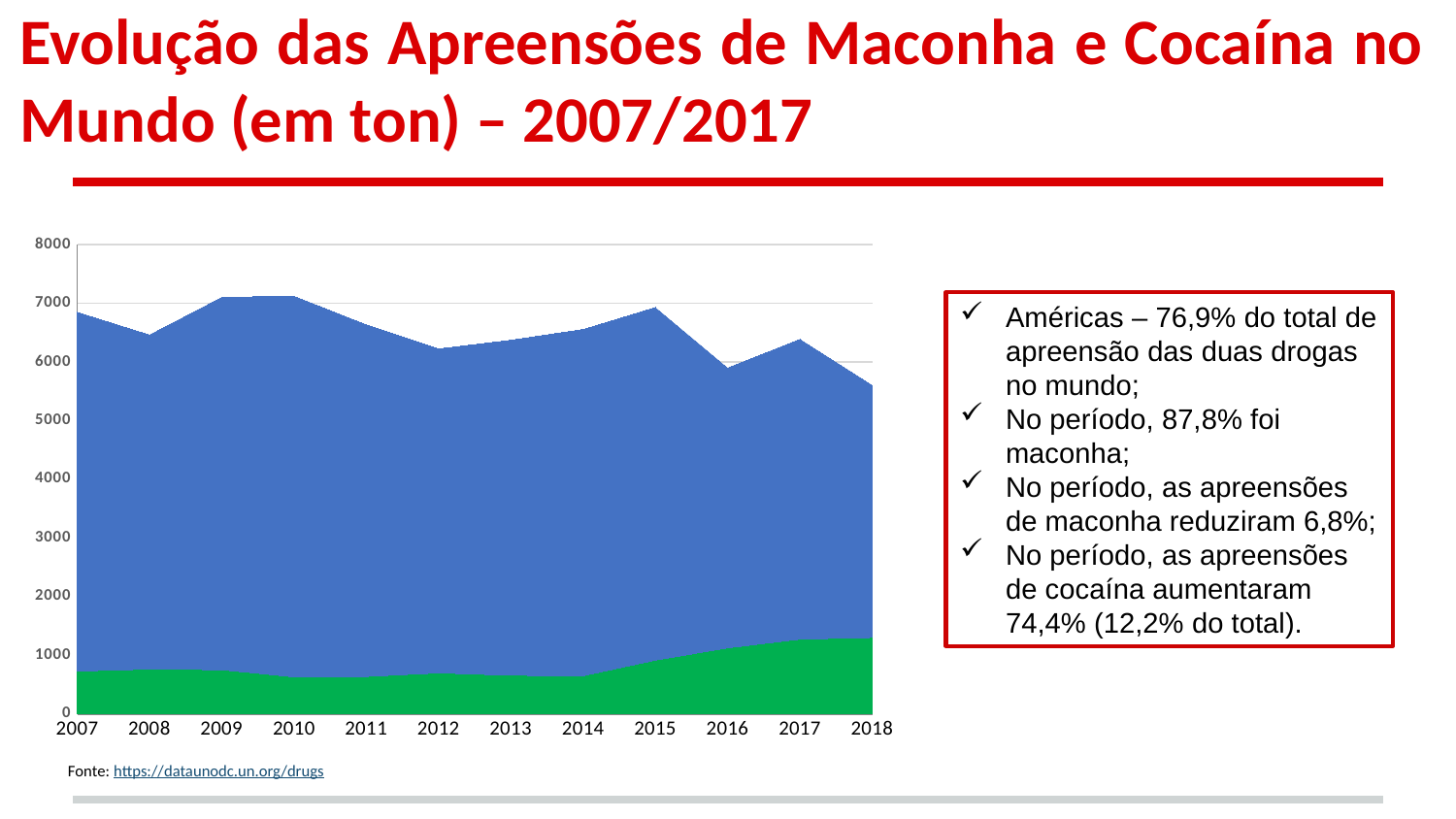
Is the total value for 2012 greater or less than 6000? greater Is the value of the green series for 2018 greater or less than 1000? greater Is the total value for 2018 greater or less than 6000? less In which year does the green series reach its highest value? 2018 How many data series are plotted in the chart? 2 What is the first year shown on the x axis of the chart? 2007 Does the total value rise or fall from 2015 to 2016? fall How many years are shown along the x axis of the chart? 12 Does the green series rise or fall from 2014 to 2018? rise What kind of chart is shown on the slide? Area chart